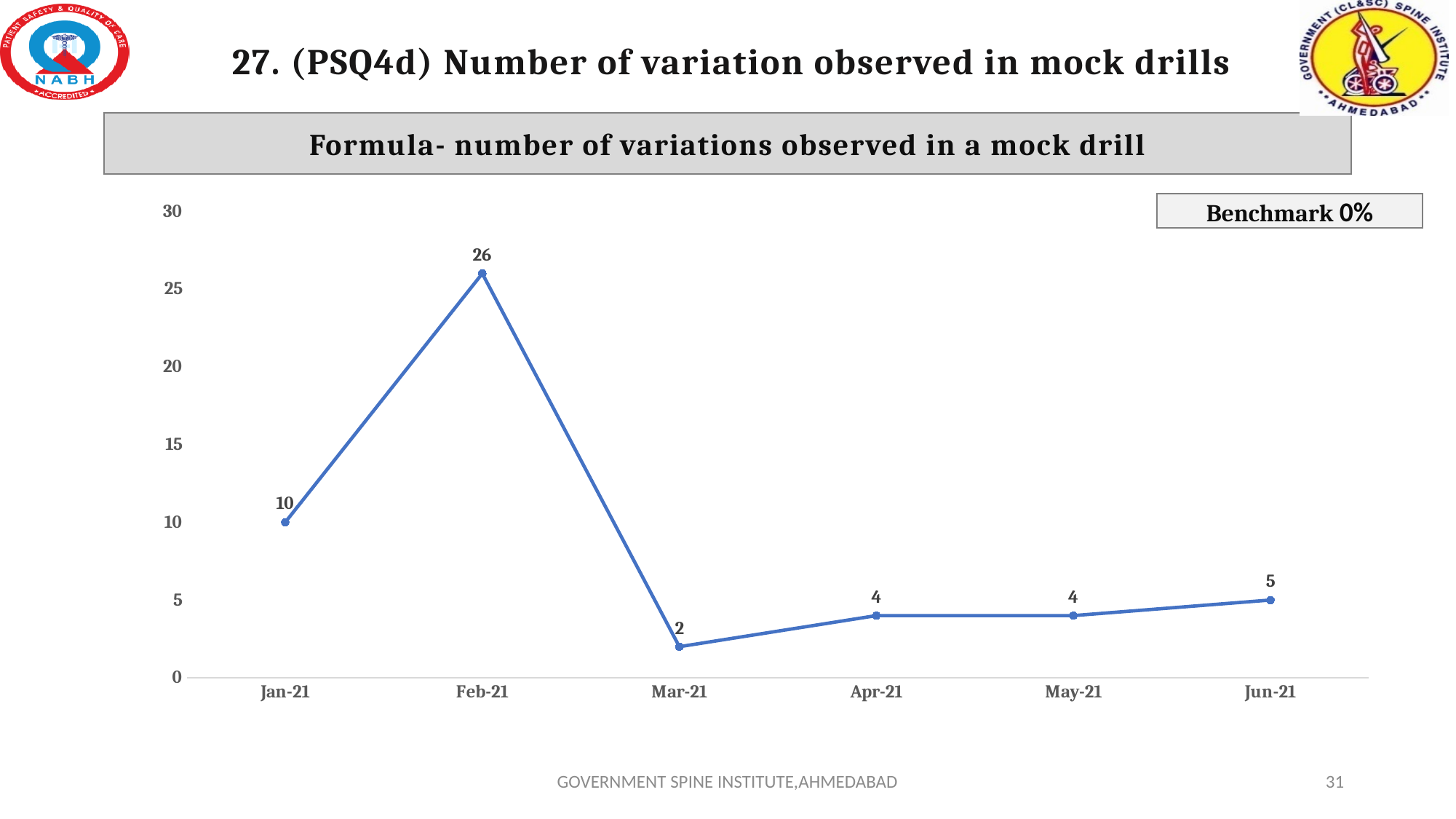
Which month has the lowest number of variations observed? Mar-21 What benchmark value is stated on the slide? 0% Which is larger, the value for Jan-21 or the value for Jun-21? Jan-21 What is the value plotted for Mar-21? 2 What is the difference between the values for Feb-21 and Jan-21? 16 What is the value plotted for Jun-21? 5 What is the difference between the values for Jun-21 and Mar-21? 3 What is the number of variations observed in mock drills for Feb-21? 26 Which month has the highest number of variations observed? Feb-21 What kind of chart is shown on the slide? Line chart What is the value plotted for Jan-21? 10 How many months are plotted on the x axis? 6